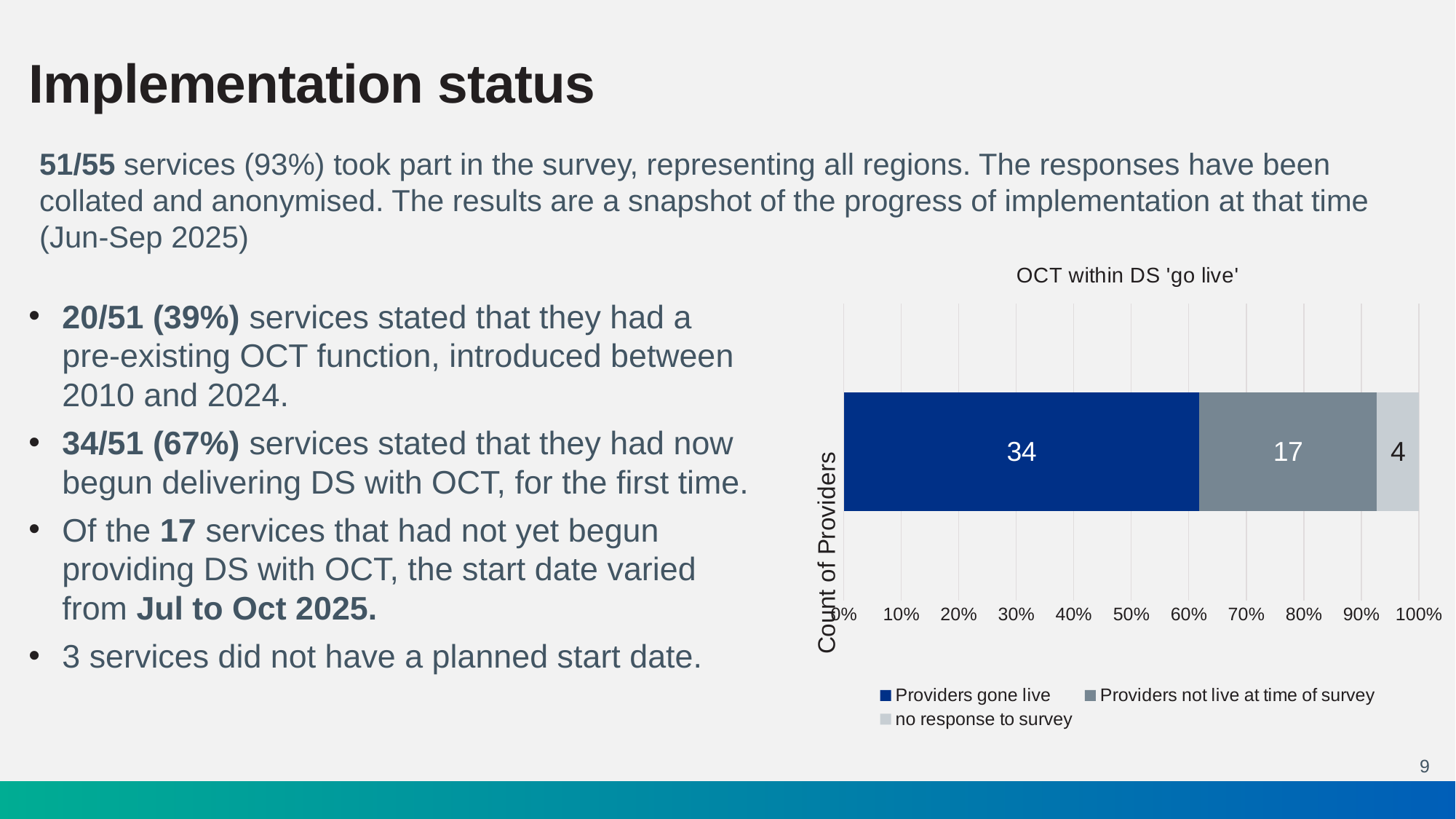
What kind of chart is shown on the slide? Stacked bar chart What is the label on the vertical axis of the chart? Count of Providers How many series does the legend list? 3 What is the title of the chart? OCT within DS 'go live' What is the value for 'no response to survey' in the chart? 4 Which series has the highest value in the chart? Providers gone live What is the total of the stacked bar in the chart? 55 Which is larger: 'Providers not live at time of survey' or 'no response to survey'? Providers not live at time of survey Which series has the lowest value in the chart? no response to survey What is the value for 'Providers not live at time of survey' in the chart? 17 What is the difference between the 'Providers gone live' value and the 'Providers not live at time of survey' value? 17 What is the value for 'Providers gone live' in the chart? 34